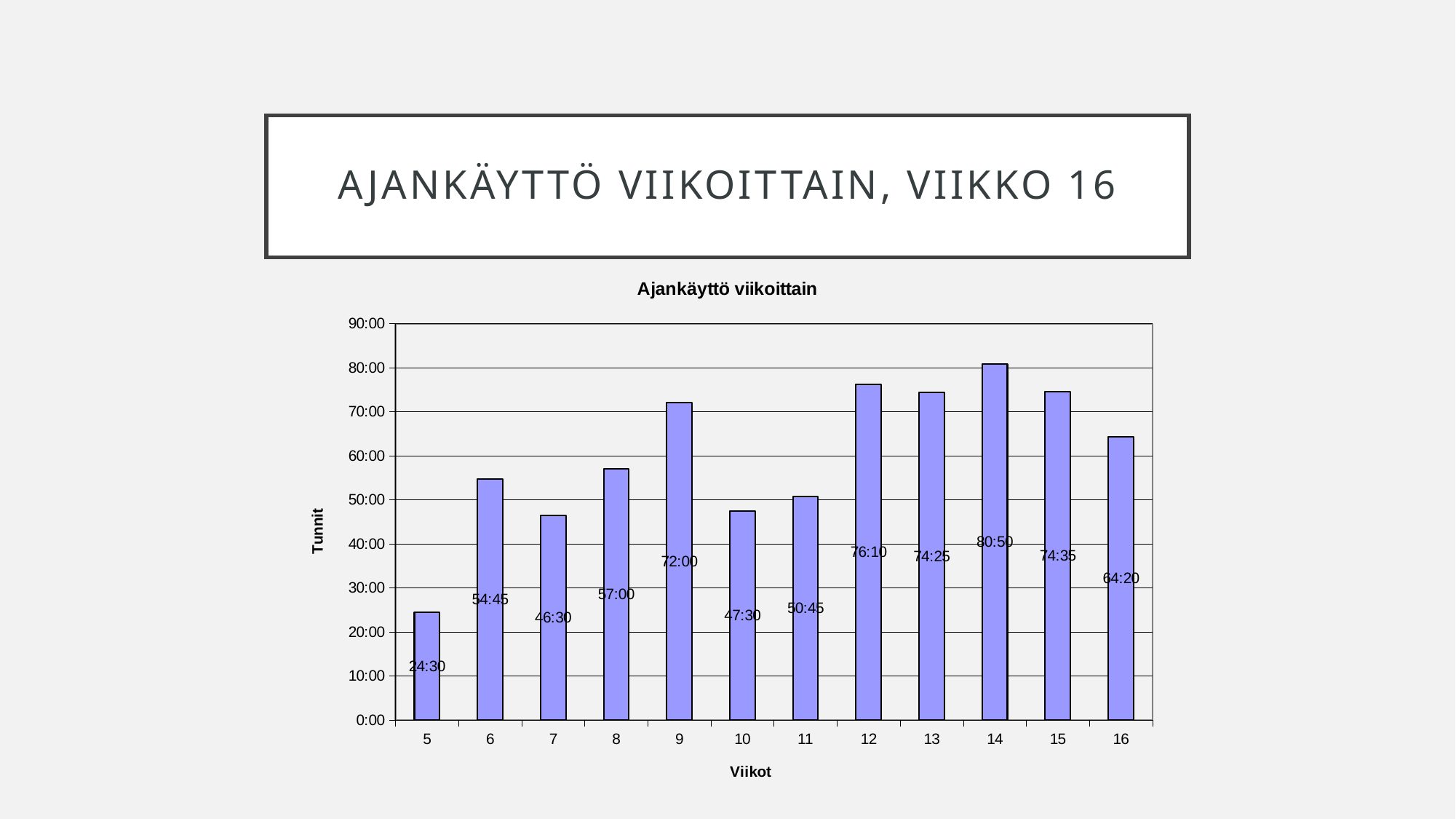
Is the value for week 10 greater or less than 50:00? less How many weeks are shown on the x axis? 12 What type of chart is shown on the slide? bar chart What is the title of the chart? Ajankäyttö viikoittain What is the value for week 16? 64:20 Which is larger, the value for week 12 or the value for week 16? week 12 Which week has the lowest value? 5 What is the value for week 11? 50:45 What is the difference between the values for week 14 and week 5? 56:20 What is the value for week 9? 72:00 What is the difference between the values for week 9 and week 8? 15:00 Which week has the highest value? 14